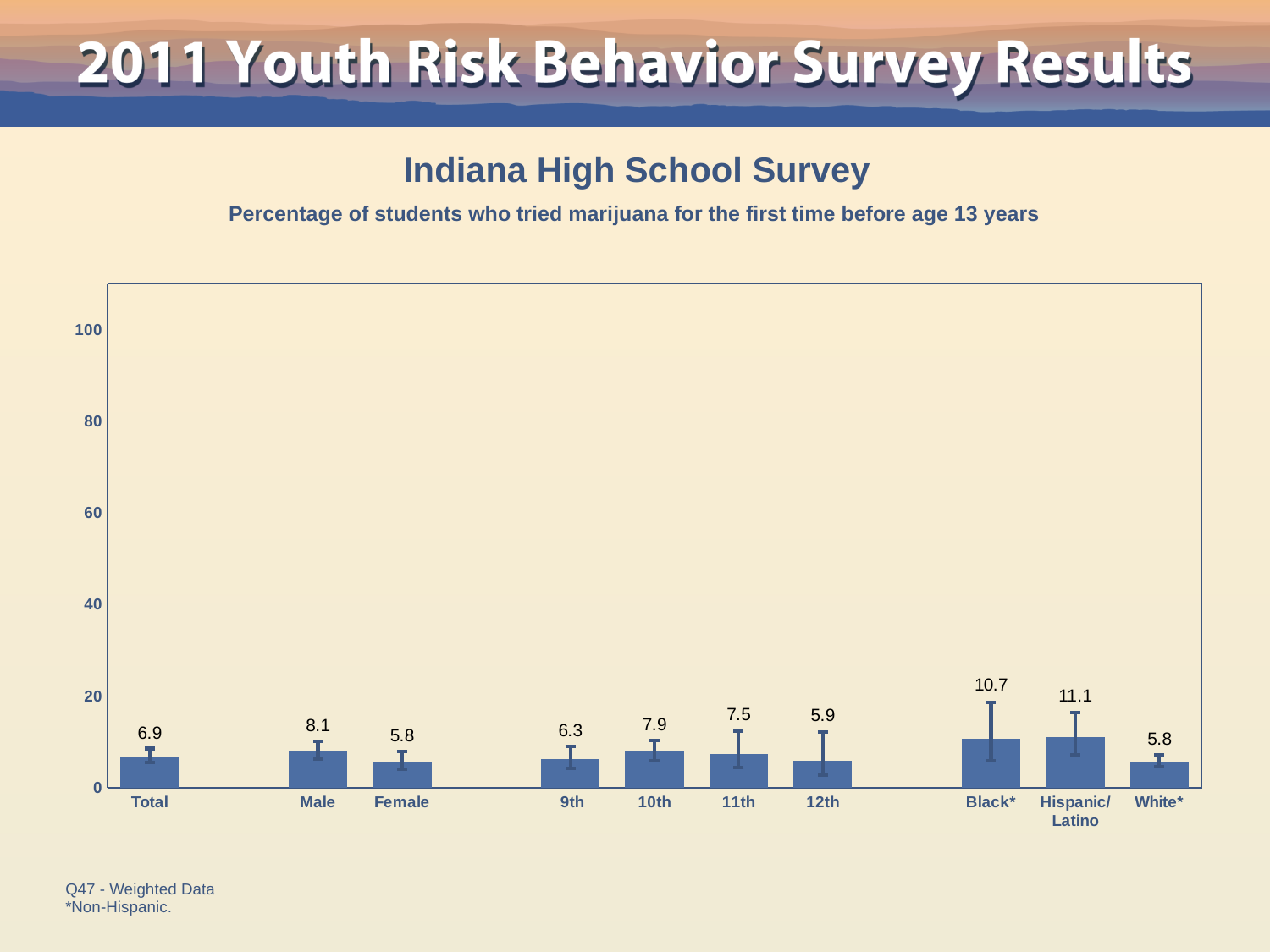
What is the chart's subtitle describing the measured percentage? Percentage of students who tried marijuana for the first time before age 13 years Which category has the highest value? Hispanic/Latino What is the value for 11th? 7.5 How many categories are shown on the x axis? 10 What kind of chart is this? bar chart Is the value for Hispanic/Latino greater or less than 20? less What is the value for Total? 6.9 What is the difference between the Male and Female values? 2.3 Which grade has the lowest value among 9th, 10th, 11th and 12th? 12th Which is larger, the value for 10th or the value for 9th? 10th What is the value for Male? 8.1 What is the value for Black*? 10.7